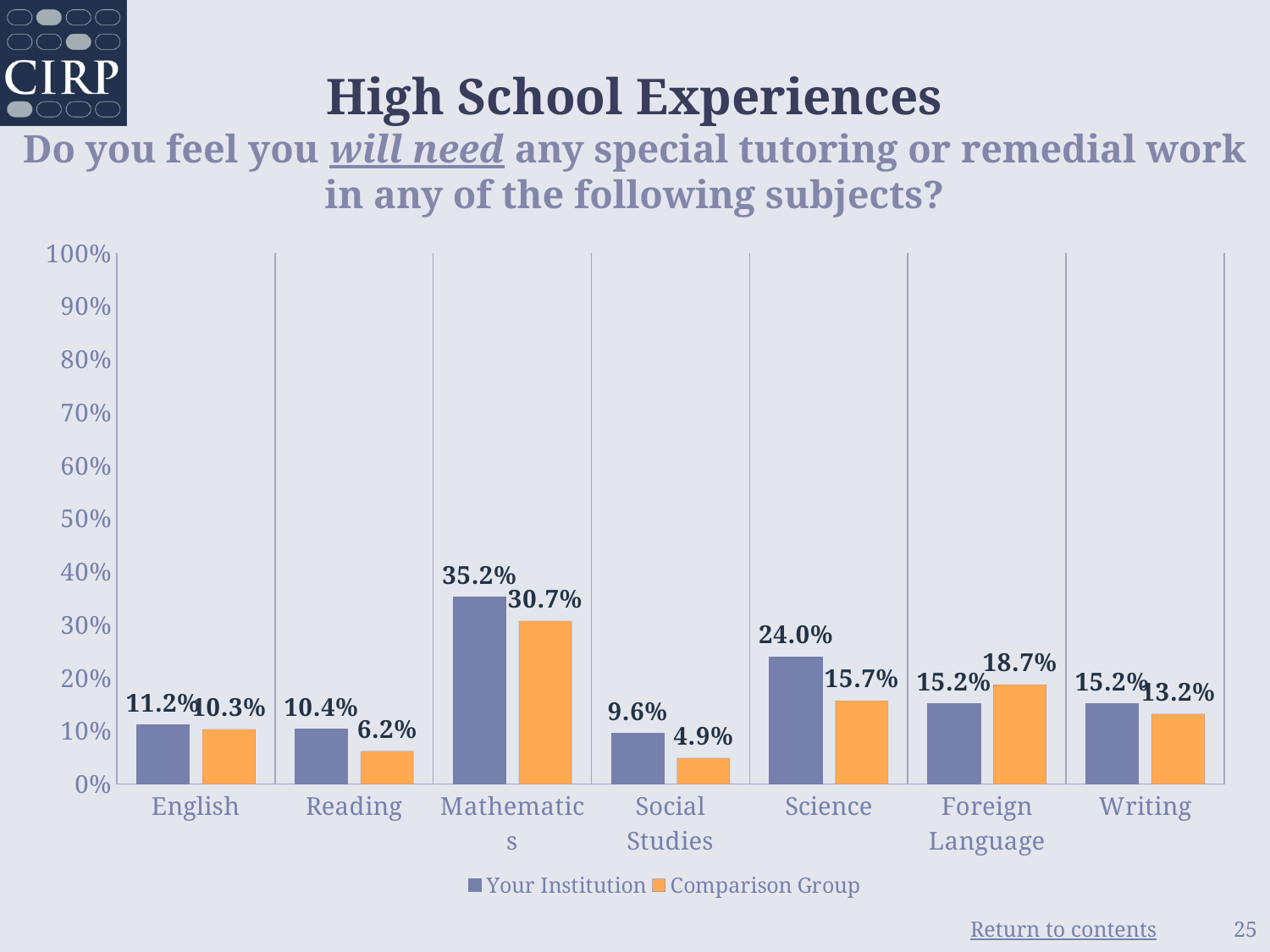
What is the difference between Your Institution and the Comparison Group in Science? 8.3% Is the value for Your Institution in Mathematics greater or less than 30%? greater Which colour represents the Comparison Group in the chart? Orange Which subject has the lowest value for Your Institution? Social Studies How many series does the legend list? 2 Which is larger in Foreign Language: Your Institution or the Comparison Group? Comparison Group What kind of chart is shown on the slide? Bar chart How many subjects are shown on the x axis? 7 What is the value for Your Institution in Science? 24.0% What is the value for the Comparison Group in Social Studies? 4.9% Which subject has the highest value for the Comparison Group? Mathematics What is the value for Your Institution in Mathematics? 35.2%